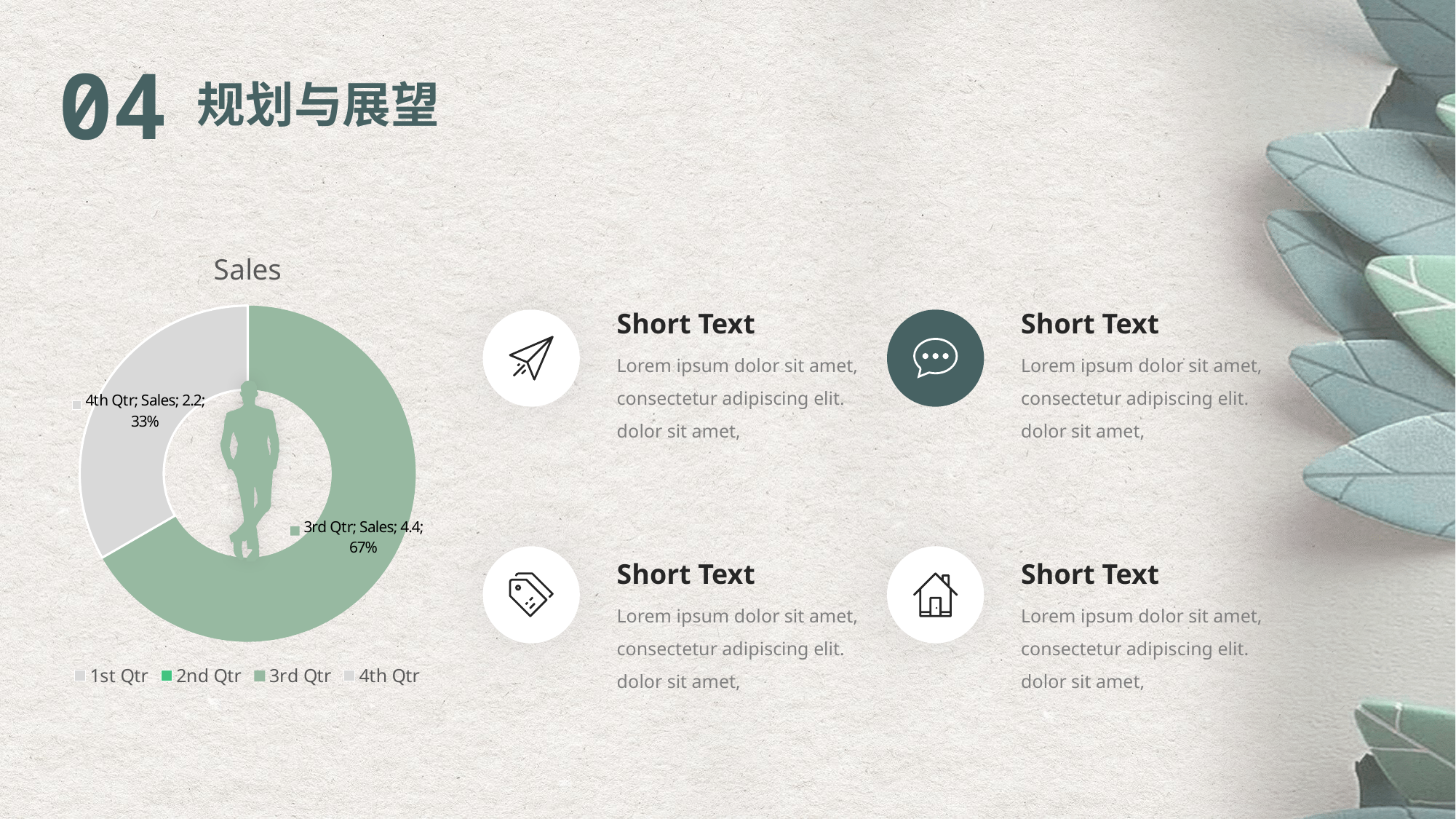
Which quarter has the largest slice in the chart? 3rd Qtr What is the Sales value for 4th Qtr? 2.2 Is the Sales value for 3rd Qtr larger or smaller than the value for 4th Qtr? larger How many entries does the legend list? 4 Which of the two labelled slices is smaller, 3rd Qtr or 4th Qtr? 4th Qtr What is the Sales value for 3rd Qtr? 4.4 What share of the chart does the 3rd Qtr slice represent? 67% What is the difference between the Sales values for 3rd Qtr and 4th Qtr? 2.2 What share of the chart does the 4th Qtr slice represent? 33% What is the title of the chart? Sales How many slices with data labels are visible in the chart? 2 What kind of chart is shown on the slide? doughnut chart